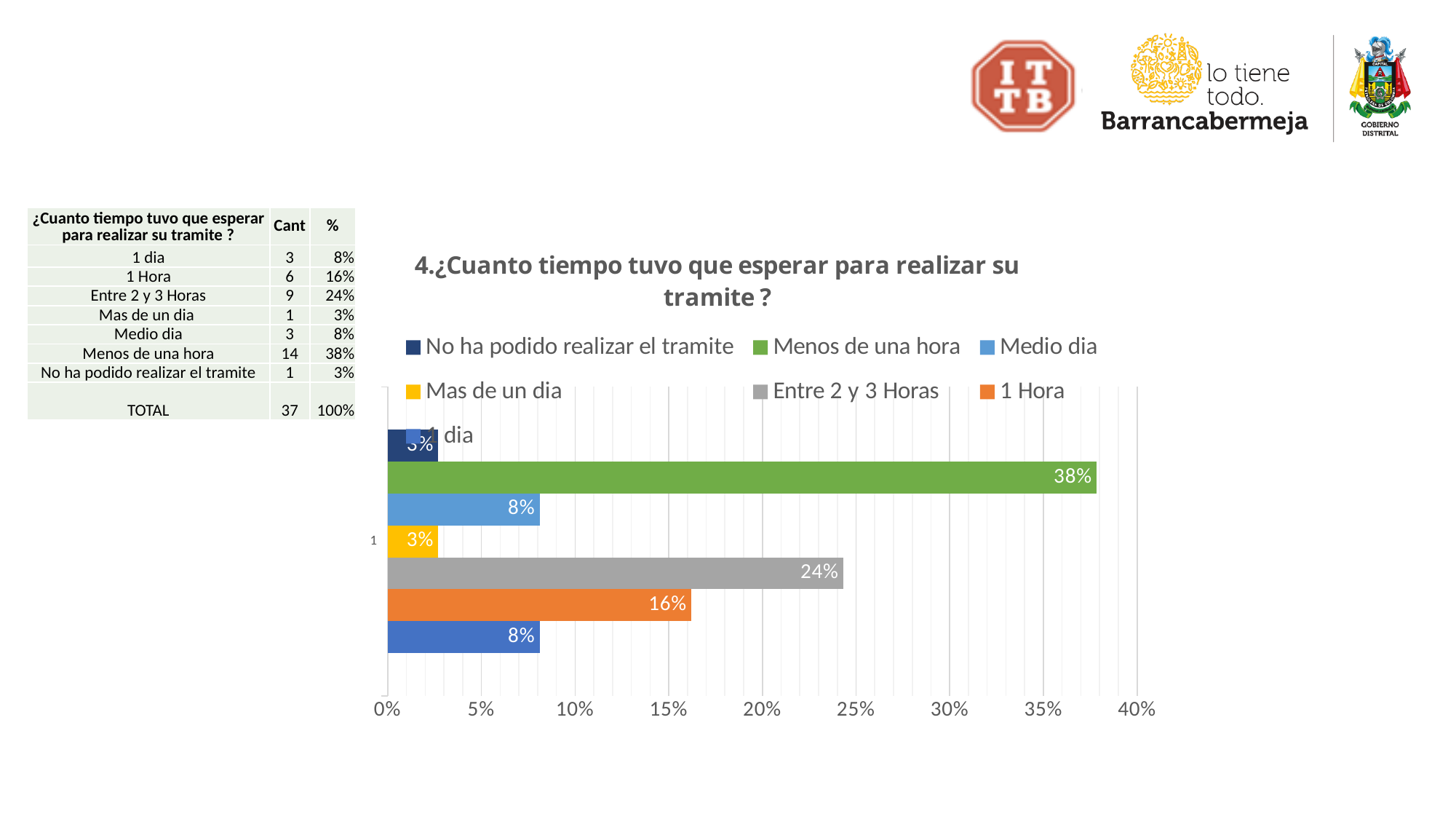
What is the value for 1 Hora in the chart? 16% What type of chart is shown on the slide? bar chart What is the value for Medio dia in the chart? 8% What is the title of the chart? 4.¿Cuanto tiempo tuvo que esperar para realizar su tramite ? How many series does the legend list? 7 What is the value for Menos de una hora in the chart? 38% Is the value for Entre 2 y 3 Horas greater or less than 20%? greater Which series has the highest value in the chart? Menos de una hora Which is larger, the value for 1 Hora or the value for Medio dia? 1 Hora What is the value for Mas de un dia in the chart? 3% What is the value for Entre 2 y 3 Horas in the chart? 24% What is the difference between the values for Menos de una hora and Entre 2 y 3 Horas? 14%